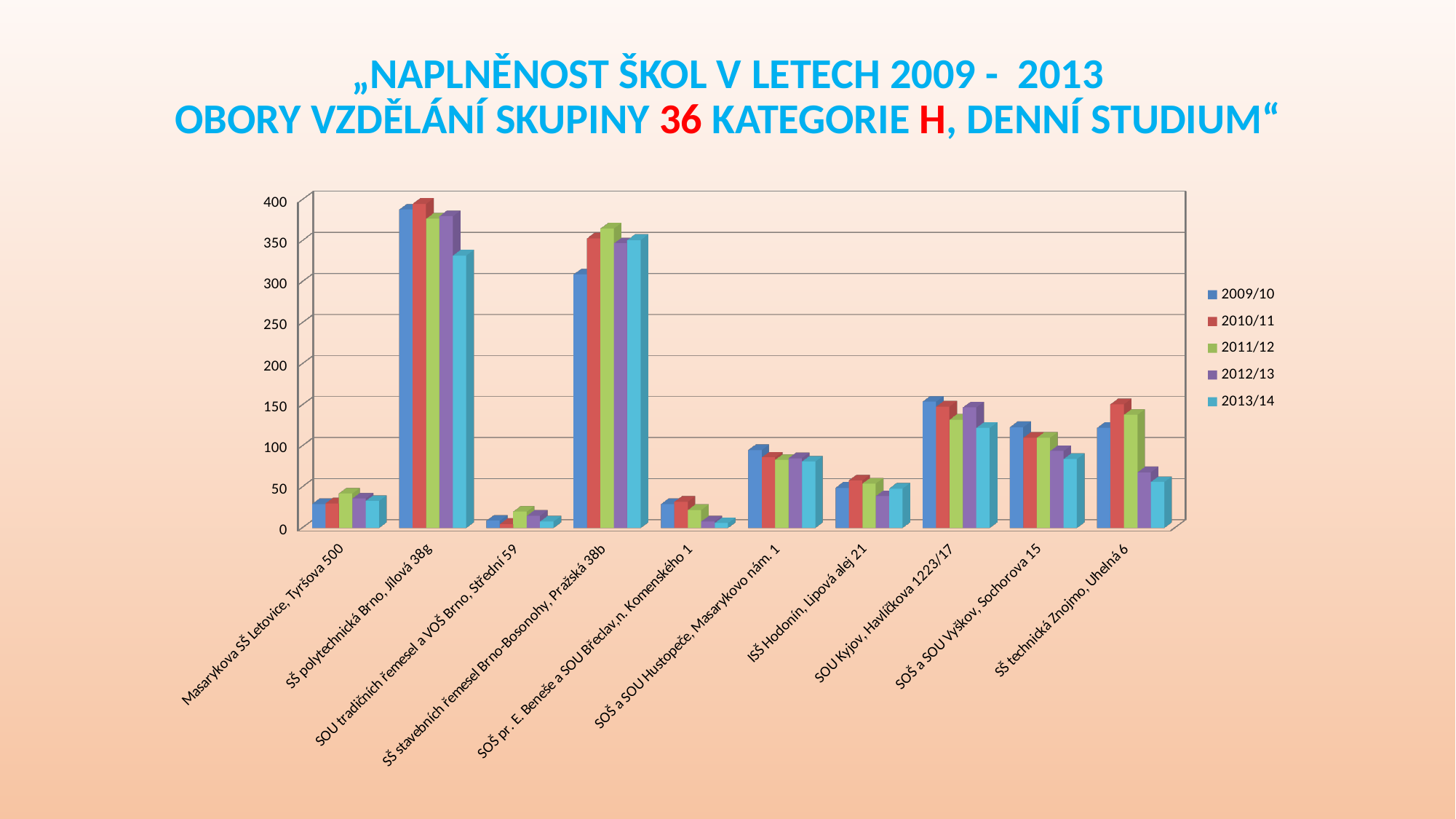
For SŠ technická Znojmo, Uhelná 6, do the values rise or fall from 2011/12 to 2013/14? fall Which is larger for 2009/10: SOU Kyjov, Havlíčkova 1223/17 or SOŠ a SOU Vyškov, Sochorova 15? SOU Kyjov, Havlíčkova 1223/17 How many series does the legend list? 5 How many schools (categories) are shown on the x axis? 10 What kind of chart is shown on the slide? bar chart Is the 2009/10 value for SŠ polytechnická Brno, Jílová 38g greater or less than 350? greater Is the 2012/13 value for ISŠ Hodonín, Lipová alej 21 greater or less than 50? less Is the 2010/11 value for SŠ technická Znojmo, Uhelná 6 greater or less than 100? greater Which school has the highest values overall in the chart? SŠ polytechnická Brno, Jílová 38g Which school has the lowest values overall in the chart? SOU tradičních řemesel a VOŠ Brno, Střední 59 Which series is listed first in the legend? 2009/10